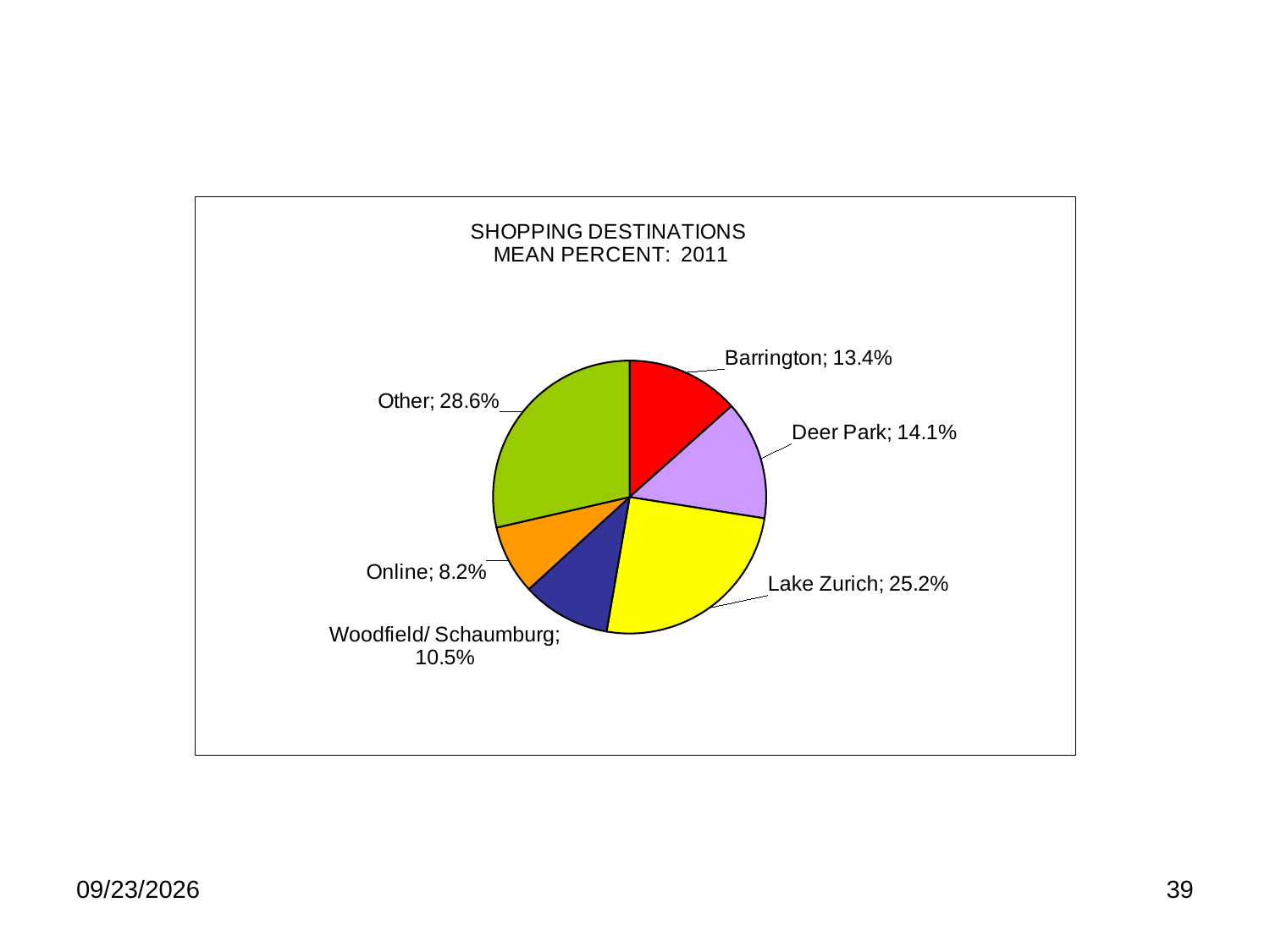
What is the title of the chart? SHOPPING DESTINATIONS MEAN PERCENT: 2011 What is the value for Online? 8.2% What is the difference between the values for Other and Lake Zurich? 3.4% What is the value for Woodfield/ Schaumburg? 10.5% Which category has the largest share of the pie? Other Which category has the smallest share of the pie? Online What is the value for Barrington? 13.4% What is the value for Lake Zurich? 25.2% Which is larger, the value for Deer Park or the value for Barrington? Deer Park How many slices does the pie chart have? 6 What kind of chart is shown on the slide? pie chart What colour is the Lake Zurich slice? yellow